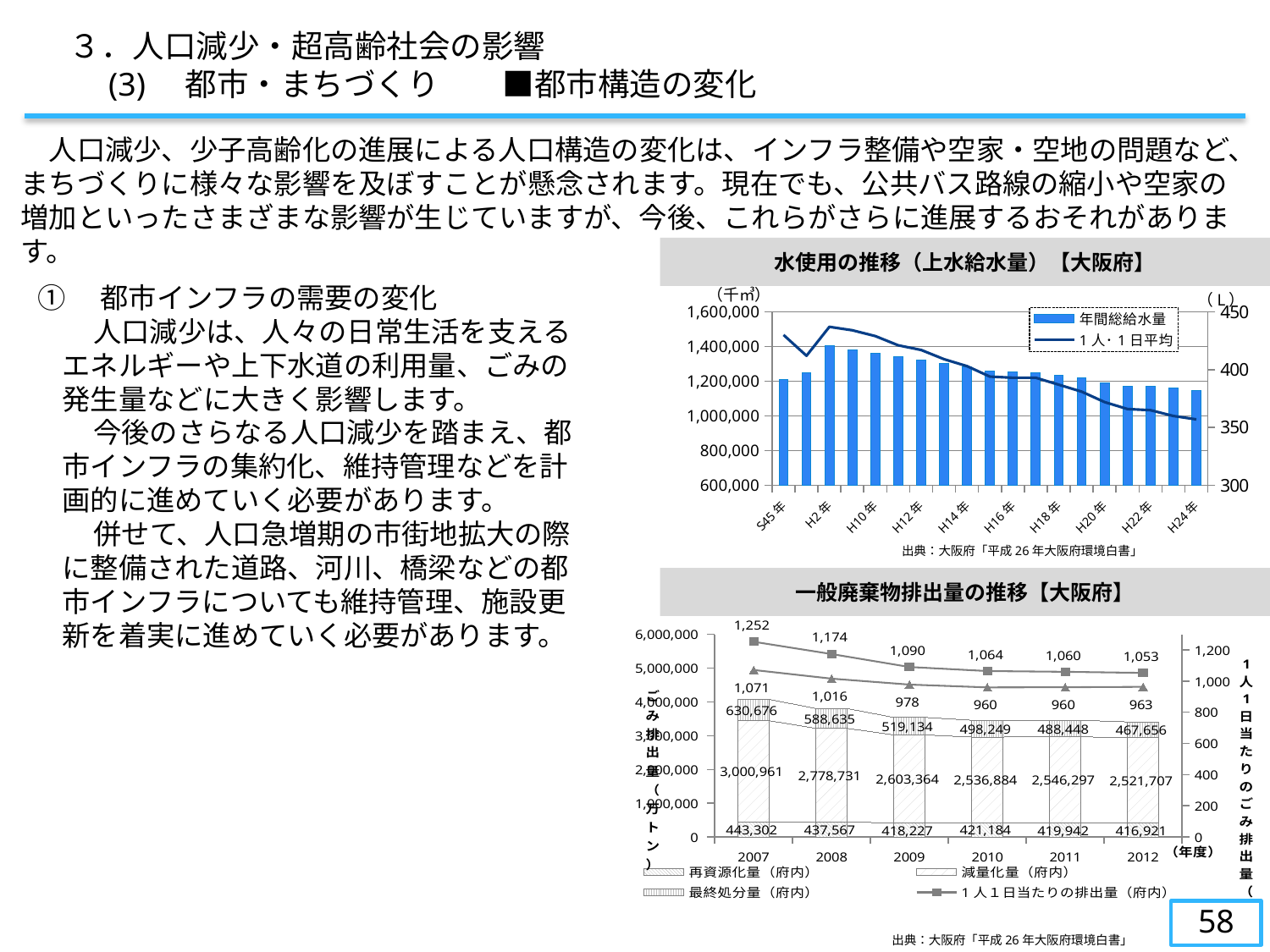
In the 一般廃棄物排出量の推移【大阪府】 chart, what is the total of the stacked bar for 2012? 3,406,284 In the 一般廃棄物排出量の推移【大阪府】 chart, how many years are shown on the x axis? 6 In the 一般廃棄物排出量の推移【大阪府】 chart, what is the difference between the 1人1日当たりの排出量（府内） values for 2007 and 2012? 199 In the 水使用の推移（上水給水量）【大阪府】 chart, does the 1人・1日平均 line rise or fall from H2年 to H24年? fall In the 水使用の推移（上水給水量）【大阪府】 chart, is the 年間総給水量 value for H24年 greater or less than 1,200,000? less In the 一般廃棄物排出量の推移【大阪府】 chart, what is the 1人1日当たりの排出量（府内） value for 2007? 1,252 In the 水使用の推移（上水給水量）【大阪府】 chart, is the 年間総給水量 value for S45年 greater or less than 1,400,000? less In the 一般廃棄物排出量の推移【大阪府】 chart, which year has the highest 再資源化量（府内） value? 2007 In the 水使用の推移（上水給水量）【大阪府】 chart, how many series does the legend list? 2 What kind of chart is the 水使用の推移（上水給水量）【大阪府】 chart? bar chart with a line series In the 一般廃棄物排出量の推移【大阪府】 chart, what is the 減量化量（府内） value for 2009? 2,603,364 In the 一般廃棄物排出量の推移【大阪府】 chart, which is larger, the 最終処分量（府内） value for 2010 or for 2011? 2010